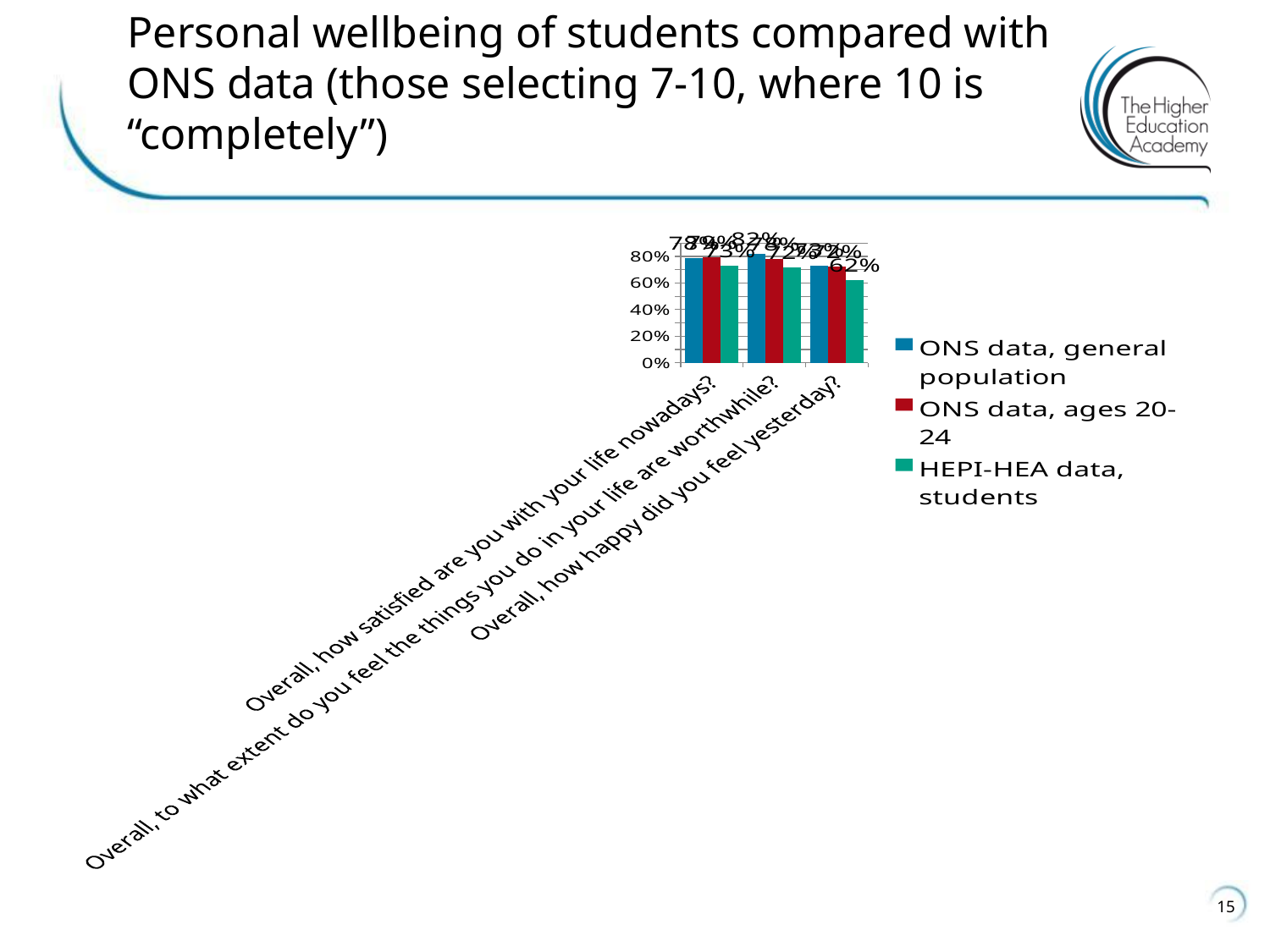
What kind of chart is shown on the slide? bar chart Do the values for HEPI-HEA data, students rise or fall across the three questions from left to right? fall How many question categories are shown on the x axis? 3 What is the highest value shown on the y axis? 80% Is the value for HEPI-HEA data, students for "Overall, to what extent do you feel the things you do in your life are worthwhile?" greater or less than 80%? less What is the value for HEPI-HEA data, students for "Overall, how happy did you feel yesterday?"? 62% Is the value for HEPI-HEA data, students for "Overall, how satisfied are you with your life nowadays?" greater or less than 60%? greater Which series has the lowest value for "Overall, how happy did you feel yesterday?"? HEPI-HEA data, students For "Overall, to what extent do you feel the things you do in your life are worthwhile?", which is larger: ONS data, general population or HEPI-HEA data, students? ONS data, general population Which series has the highest value for "Overall, how satisfied are you with your life nowadays?"? ONS data, ages 20-24 How many series does the legend list? 3 Which series is shown in green in the legend? HEPI-HEA data, students